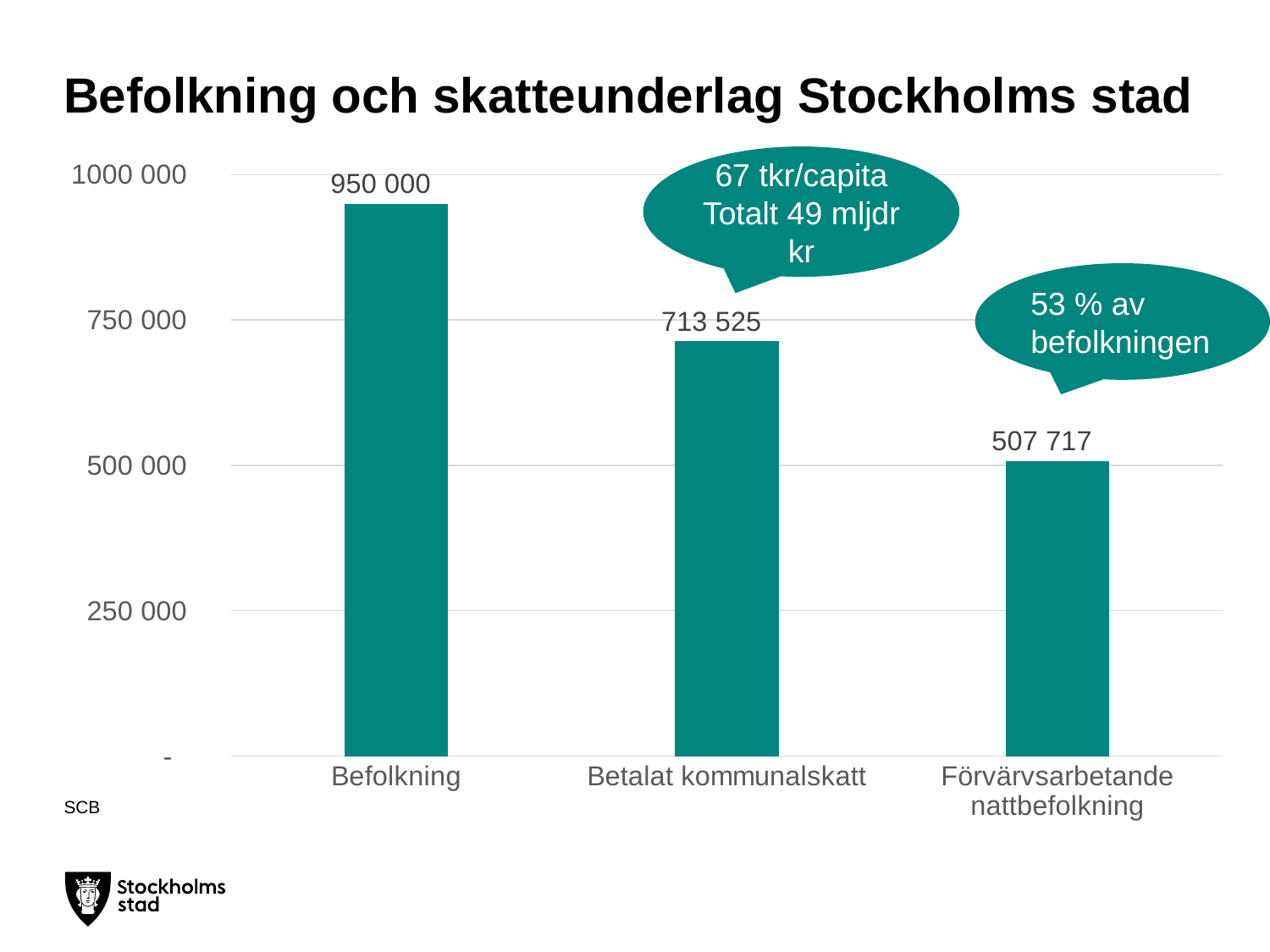
What is the value for Befolkning? 950 000 Which category has the lowest value? Förvärvsarbetande nattbefolkning How many categories are shown in the chart? 3 Which is larger, the value for Betalat kommunalskatt or the value for Förvärvsarbetande nattbefolkning? Betalat kommunalskatt What is the difference between the values for Befolkning and Betalat kommunalskatt? 236 475 What is the value for Betalat kommunalskatt? 713 525 What is the value for Förvärvsarbetande nattbefolkning? 507 717 Which category has the highest value? Befolkning Is the value for Förvärvsarbetande nattbefolkning greater or less than 750 000? less What is the difference between the values for Betalat kommunalskatt and Förvärvsarbetande nattbefolkning? 205 808 What is the title of the chart? Befolkning och skatteunderlag Stockholms stad What kind of chart is shown on the slide? bar chart